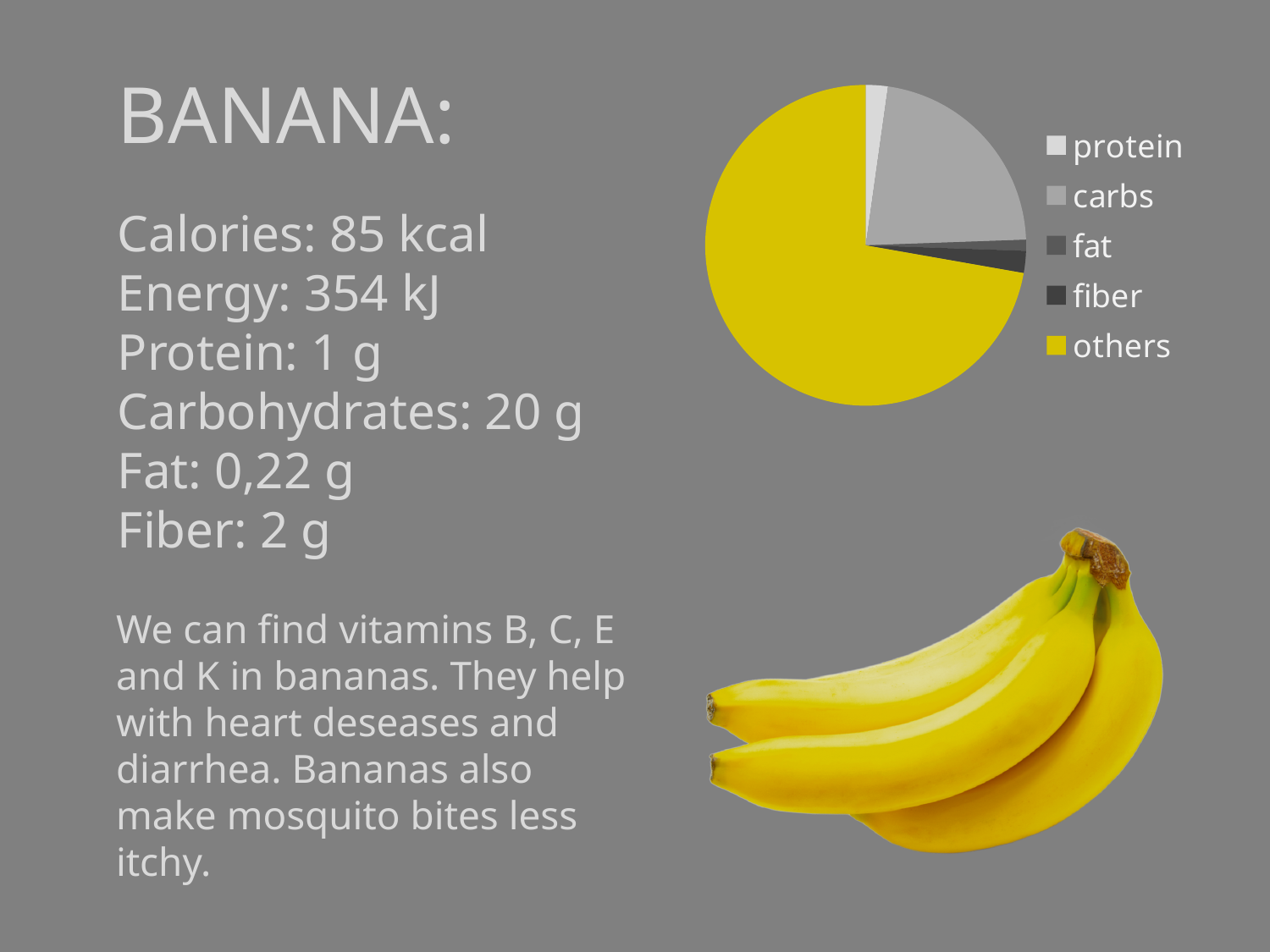
Which category is shown in yellow in the pie chart? others Which slice is larger in the pie chart, carbs or others? others What kind of chart is shown on the slide? pie chart How many categories does the pie chart's legend list? 5 Which slice is larger in the pie chart, carbs or protein? carbs Which slice is larger in the pie chart, carbs or fiber? carbs What is the first entry listed in the pie chart's legend? protein Which category has the largest slice in the pie chart? others